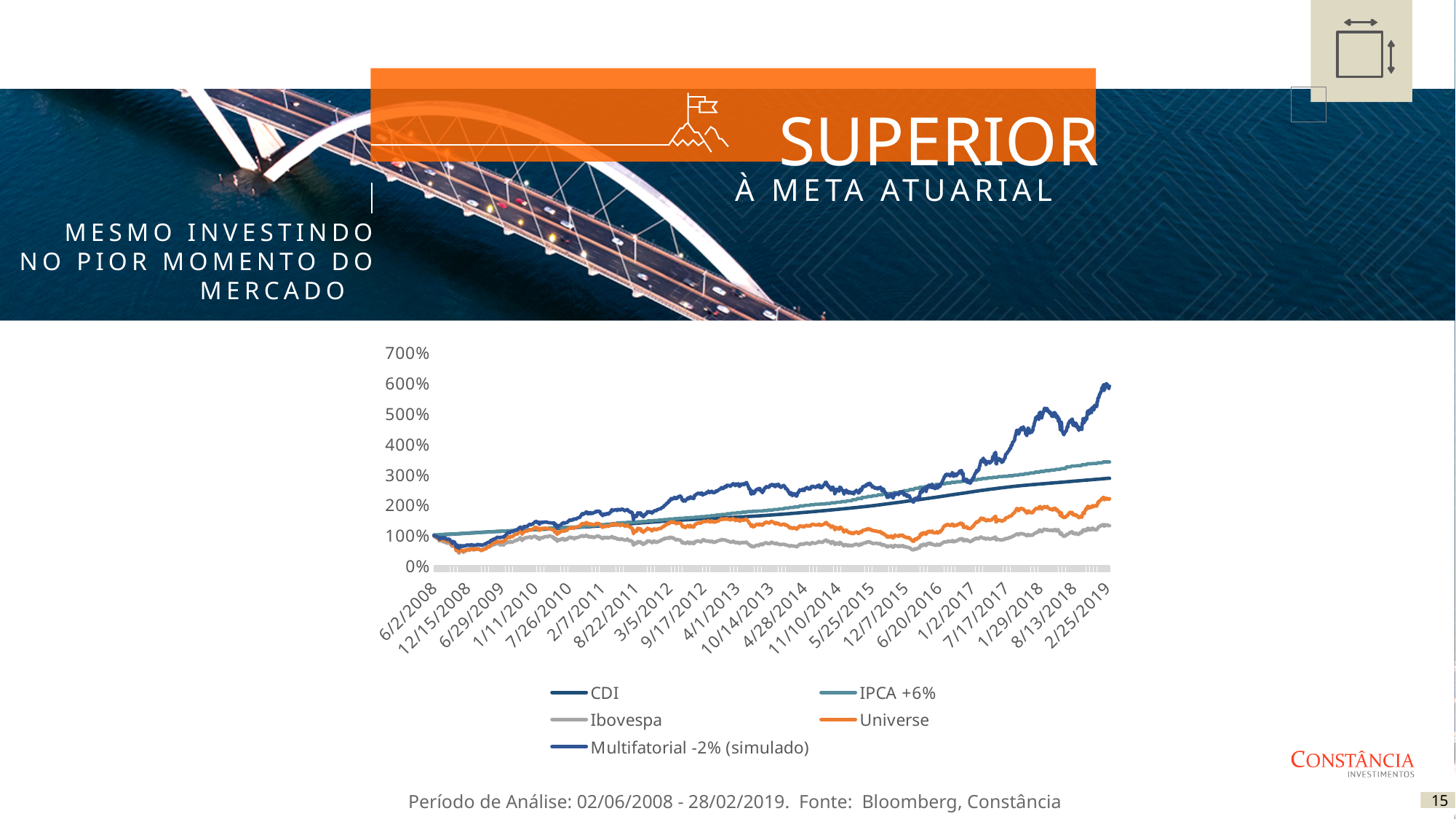
Is the value of IPCA +6% at the end of the period greater or less than 300%? greater Which series has the highest value at the end of the period (2/25/2019)? Multifatorial -2% (simulado) What is the first date label on the x axis? 6/2/2008 Is the value of Ibovespa at the end of the period greater or less than 200%? less Is the value of Universe at the end of the period greater or less than 300%? less What is the highest value shown on the y axis? 700% Which series has the lowest value at the end of the period (2/25/2019)? Ibovespa How many series does the legend list? 5 What kind of chart is shown on the slide? Line chart At the end of the period, which is higher: IPCA +6% or CDI? IPCA +6% Does the Multifatorial -2% (simulado) series rise or fall overall from 6/2/2008 to 2/25/2019? Rise